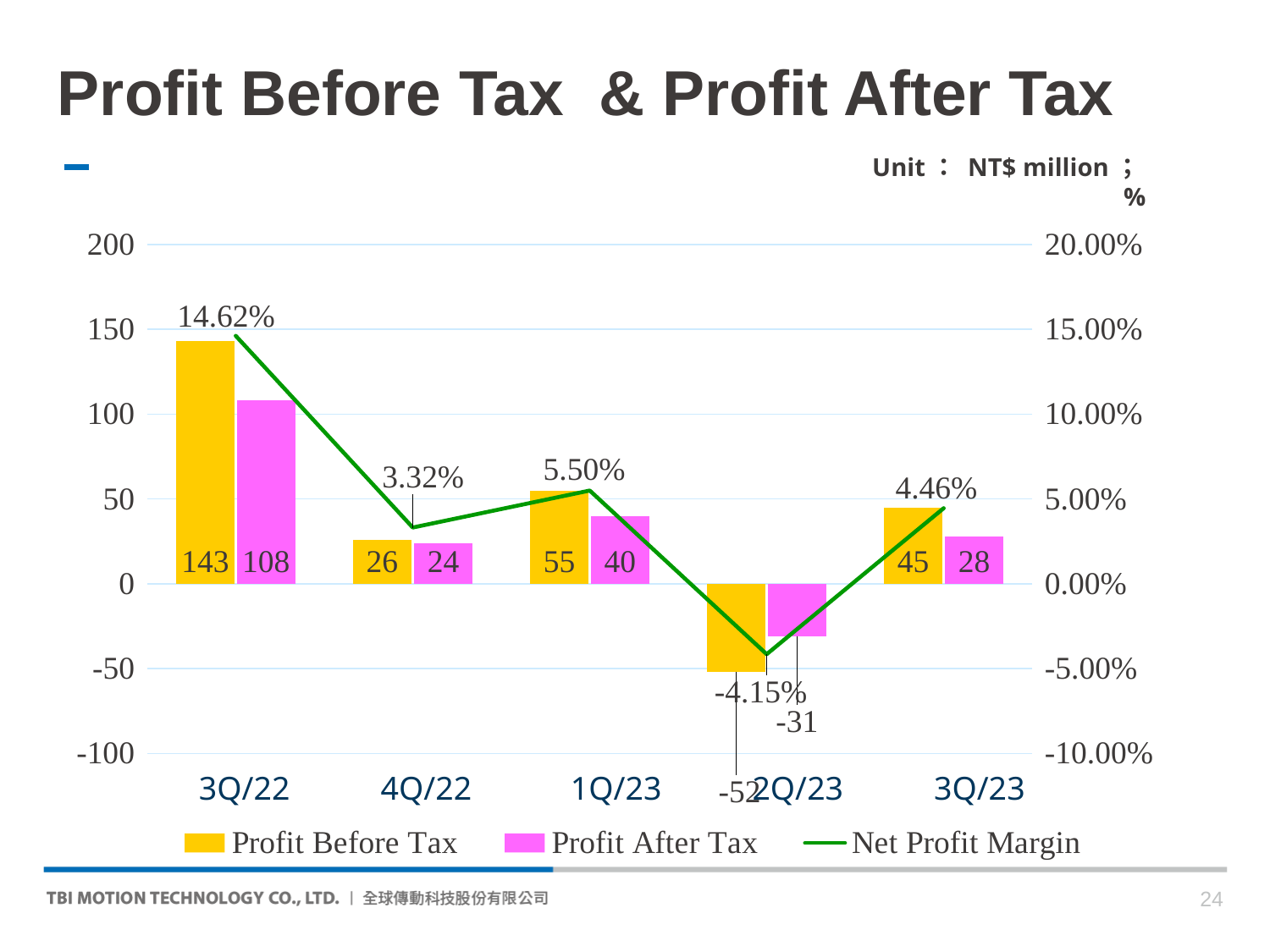
How many quarters are shown on the x axis? 5 What kind of chart is used for Profit Before Tax and Profit After Tax? Bar chart What is the Net Profit Margin for 4Q/22? 3.32% Does the Net Profit Margin rise or fall from 2Q/23 to 3Q/23? Rise What is the Profit After Tax value for 2Q/23? -31 How many series does the legend list? 3 Which quarter has the lowest Net Profit Margin? 2Q/23 What is the difference between Profit Before Tax and Profit After Tax in 3Q/22? 35 What is the Profit Before Tax value for 3Q/22? 143 Which is larger, Profit Before Tax in 1Q/23 or Profit Before Tax in 3Q/23? Profit Before Tax in 1Q/23 What is the Profit After Tax value for 1Q/23? 40 Which quarter has the highest Profit Before Tax? 3Q/22